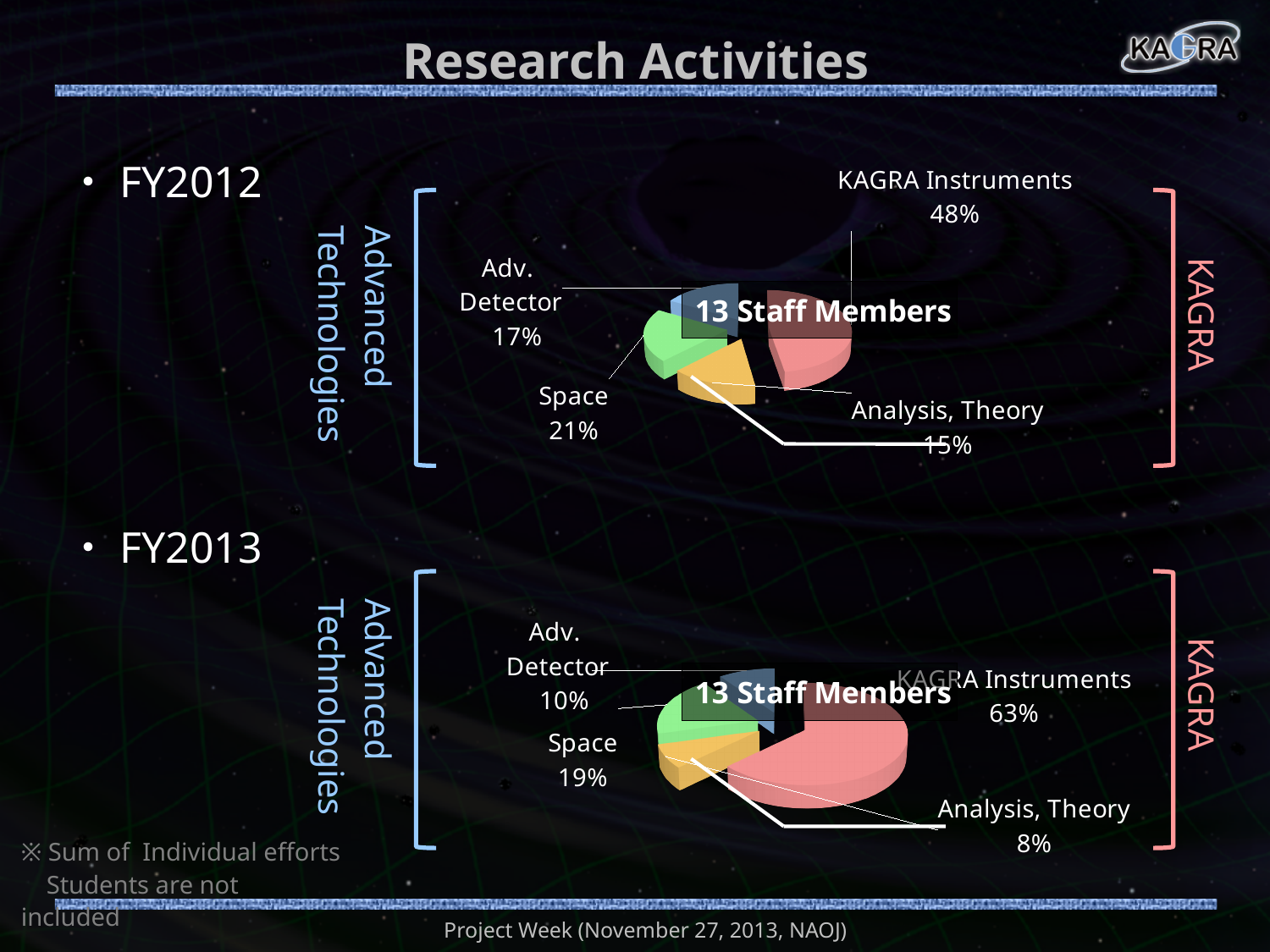
In the FY2013 pie chart, what is the difference in percentage points between KAGRA Instruments and Space? 44 In the FY2012 pie chart, which category has the smallest share? Analysis, Theory In the FY2013 pie chart, which is larger, Space or Adv. Detector? Space In the FY2012 pie chart, which category has the largest share? KAGRA Instruments What type of chart is used for FY2012? Pie chart In the FY2013 pie chart, what share is labelled for Analysis, Theory? 8% In the FY2013 pie chart, what share is labelled for KAGRA Instruments? 63% How many slices does the FY2013 pie chart have? 4 In the FY2012 pie chart, what is the difference in percentage points between Space and Adv. Detector? 4 In the FY2012 pie chart, what share is labelled for Space? 21% In the FY2012 pie chart, what share is labelled for KAGRA Instruments? 48% What title is printed on the FY2013 pie chart? 13 Staff Members